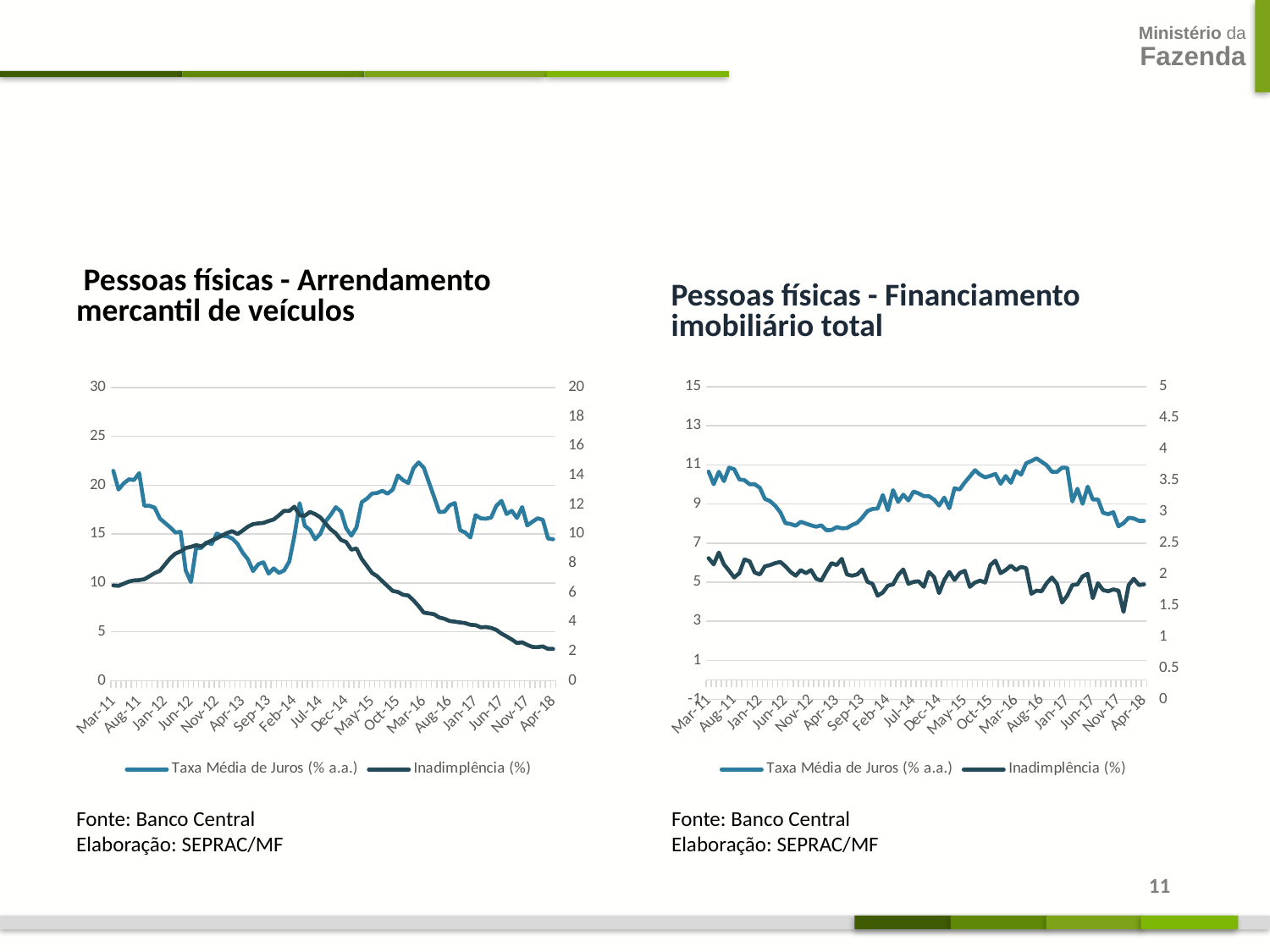
In the 'Pessoas físicas - Arrendamento mercantil de veículos' chart, is the Taxa Média de Juros (% a.a.) higher at Mar-11 or at Apr-18? Mar-11 How many series does the legend of the 'Pessoas físicas - Financiamento imobiliário total' chart list? 2 How many series does the legend of the 'Pessoas físicas - Arrendamento mercantil de veículos' chart list? 2 What kind of chart is the 'Pessoas físicas - Financiamento imobiliário total' chart? Line chart In the 'Pessoas físicas - Financiamento imobiliário total' chart, is the Inadimplência (%) value at Apr-18 greater or less than 2.5 on the right axis? less In the 'Pessoas físicas - Arrendamento mercantil de veículos' chart, is the Inadimplência (%) value at Apr-18 greater or less than 4 on the right axis? less In the 'Pessoas físicas - Financiamento imobiliário total' chart, is the Taxa Média de Juros (% a.a.) value at Apr-18 greater or less than 11? less In the 'Pessoas físicas - Arrendamento mercantil de veículos' chart, what are the two series named in the legend? Taxa Média de Juros (% a.a.) and Inadimplência (%) In the 'Pessoas físicas - Financiamento imobiliário total' chart, is the Taxa Média de Juros (% a.a.) higher at Mar-11 or at Apr-18? Mar-11 In the 'Pessoas físicas - Arrendamento mercantil de veículos' chart, does the Inadimplência (%) line end higher or lower at Apr-18 than it started at Mar-11? Lower What kind of chart is the 'Pessoas físicas - Arrendamento mercantil de veículos' chart? Line chart